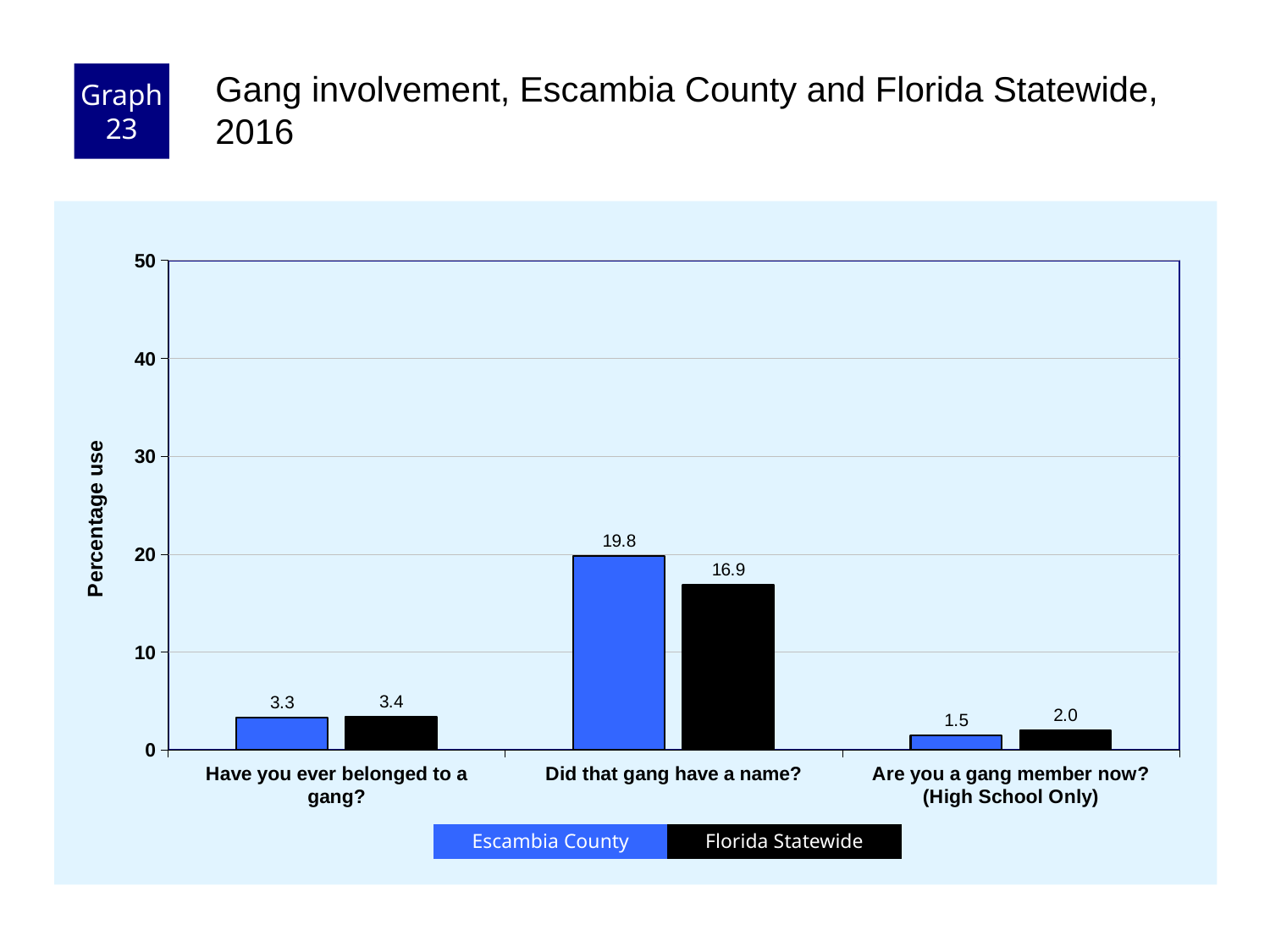
What is the difference between the Escambia County and Florida Statewide values for "Did that gang have a name?"? 2.9 What is the Escambia County value for "Did that gang have a name?"? 19.8 Which question has the highest Florida Statewide value? Did that gang have a name? Which question has the lowest Escambia County value? Are you a gang member now? (High School Only) Is the Florida Statewide value for "Did that gang have a name?" greater or less than 20? less For "Are you a gang member now? (High School Only)", which is larger: Escambia County or Florida Statewide? Florida Statewide How many series does the legend list? 2 What is the Florida Statewide value for "Have you ever belonged to a gang?"? 3.4 What kind of chart is shown on the slide? bar chart What is the label of the y axis? Percentage use How many question categories are shown on the x axis? 3 What is the Escambia County value for "Are you a gang member now? (High School Only)"? 1.5